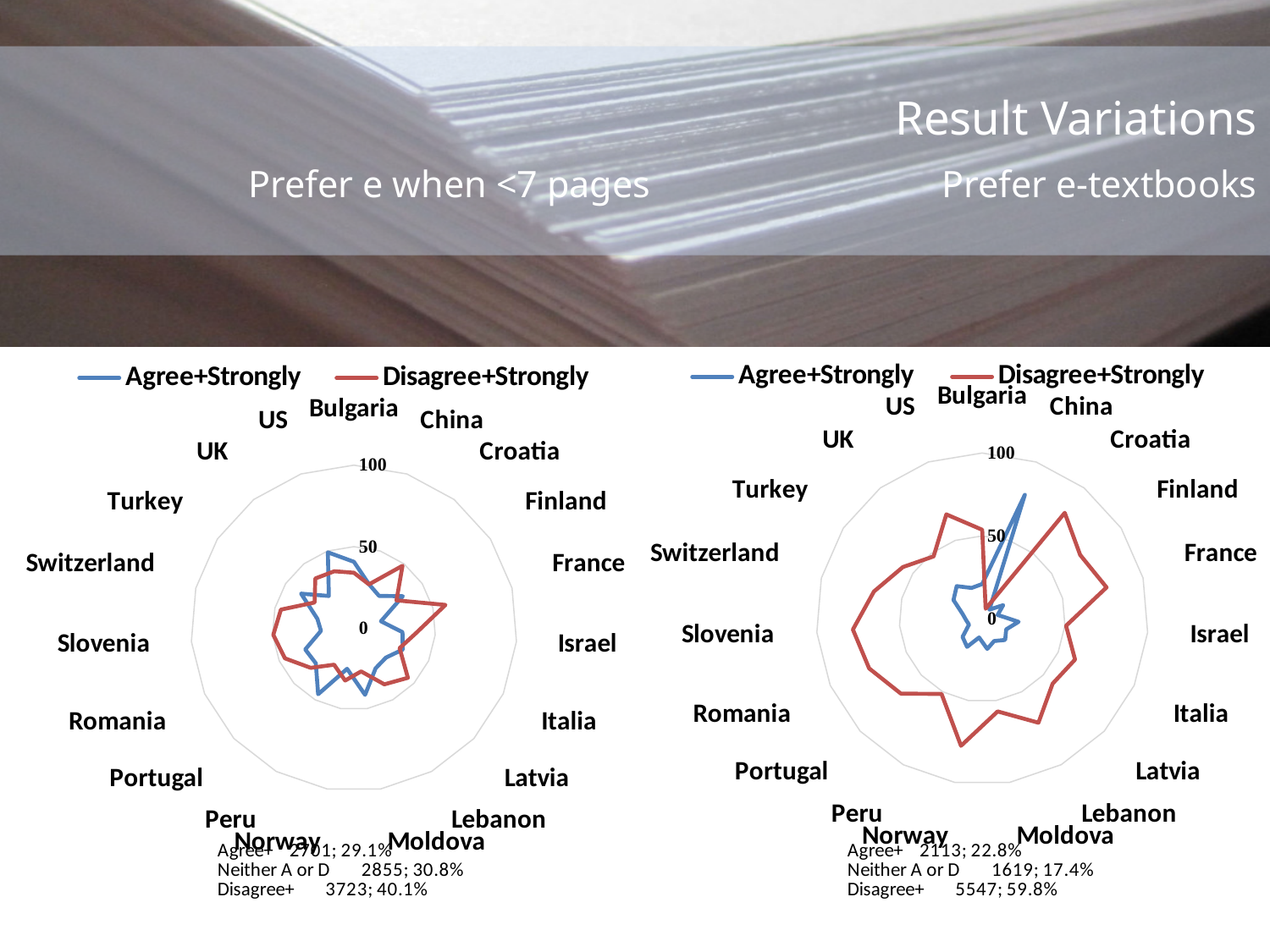
In the 'Prefer e-textbooks' chart, which colour is used for the Disagree+Strongly series? red In the 'Prefer e-textbooks' chart, which series has the larger value for Bulgaria, Agree+Strongly or Disagree+Strongly? Disagree+Strongly In the 'Prefer e-textbooks' chart, which series has the larger value for Israel, Agree+Strongly or Disagree+Strongly? Disagree+Strongly In the 'Prefer e when <7 pages' chart, is the Agree+Strongly value for Romania greater or less than 50? less In the 'Prefer e-textbooks' chart, is the Agree+Strongly value for Israel greater or less than 50? less How many countries are plotted around the 'Prefer e-textbooks' chart? 19 What is the highest value shown on the axis of the 'Prefer e when <7 pages' chart? 100 In the 'Prefer e-textbooks' chart, is the Agree+Strongly value for Bulgaria greater or less than 50? less How many series does the legend of the 'Prefer e when <7 pages' chart list? 2 What kind of chart is the 'Prefer e-textbooks' chart on the right? radar chart